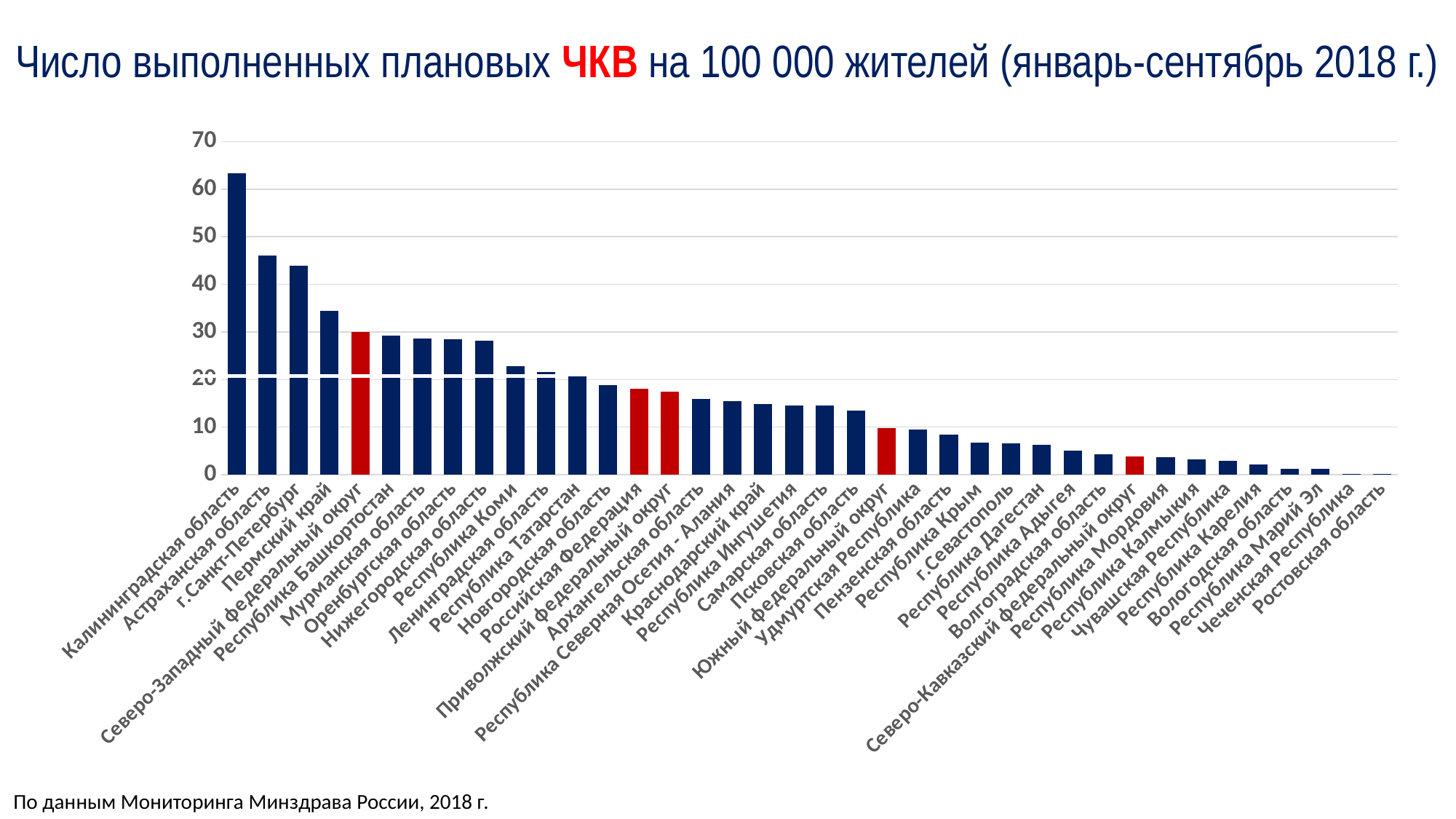
Is the value for Калининградская область greater or less than 60? greater Which region has the highest number of planned PCI per 100,000 residents? Калининградская область Is the value for Республика Крым greater or less than 10? less What kind of chart is shown on the slide? bar chart Which is larger, the value for Астраханская область or the value for Пермский край? Астраханская область Is the value for Астраханская область greater or less than 40? greater How many bars are coloured red on the chart? 5 Do the values rise or fall moving from left to right along the x axis? fall What period does the chart title say the data covers? январь-сентябрь 2018 г. How many categories (bars) are plotted on the chart? 38